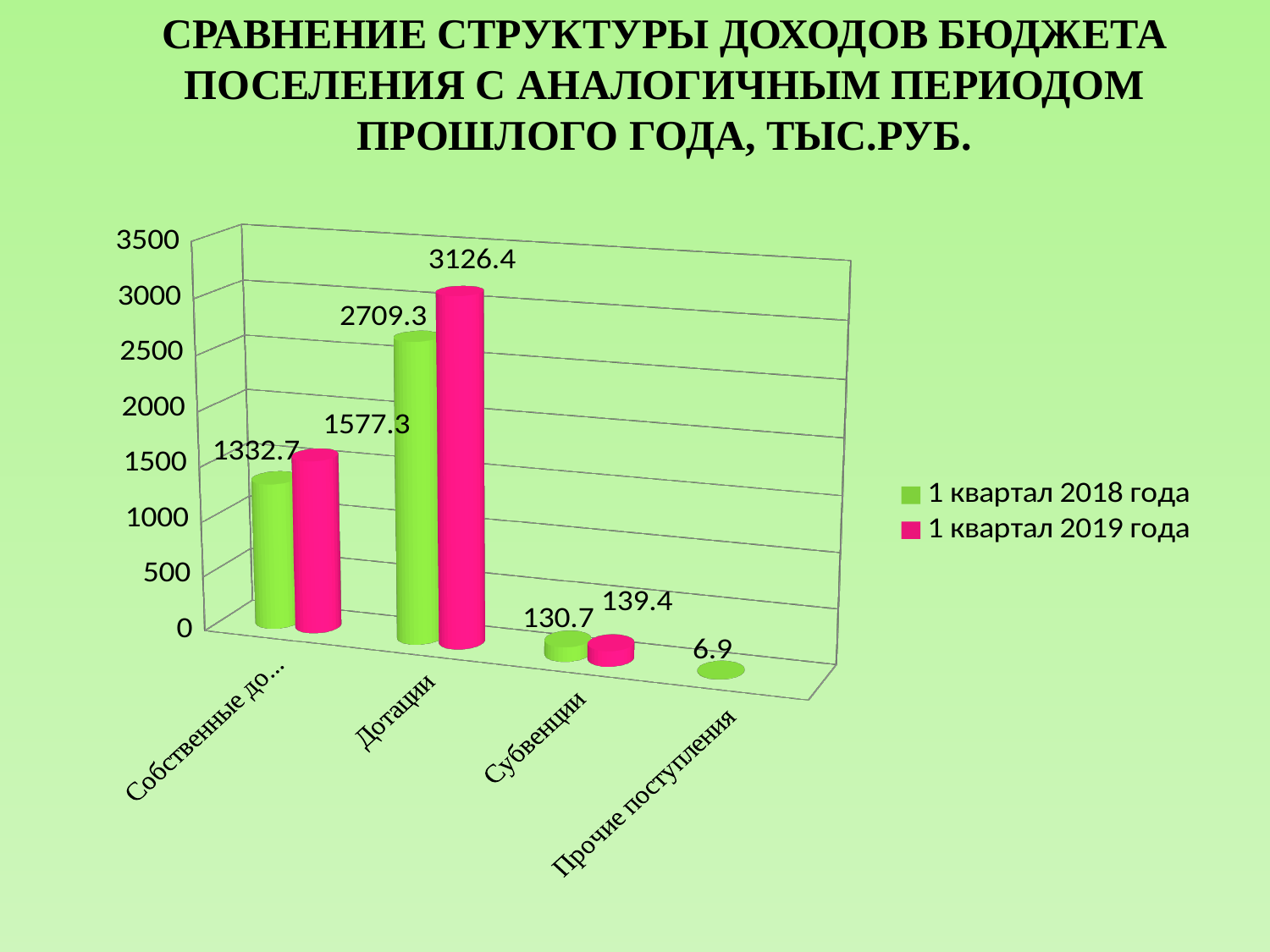
What type of chart is shown on the slide? bar chart Which series is shown in pink in the legend? 1 квартал 2019 года What is the value for Дотации in 1 квартал 2018 года? 2709.3 What is the difference between the 1 квартал 2019 года and 1 квартал 2018 года values for Субвенции? 8.7 How many series does the legend list? 2 What is the value for Прочие поступления in 1 квартал 2018 года? 6.9 What is the value for Дотации in 1 квартал 2019 года? 3126.4 What is the difference between the 1 квартал 2019 года and 1 квартал 2018 года values for Дотации? 417.1 Which is larger for Субвенции: the 1 квартал 2018 года value or the 1 квартал 2019 года value? 1 квартал 2019 года What is the value for Субвенции in 1 квартал 2018 года? 130.7 Which category has the highest value in 1 квартал 2019 года? Дотации Which category has the lowest value in 1 квартал 2018 года? Прочие поступления